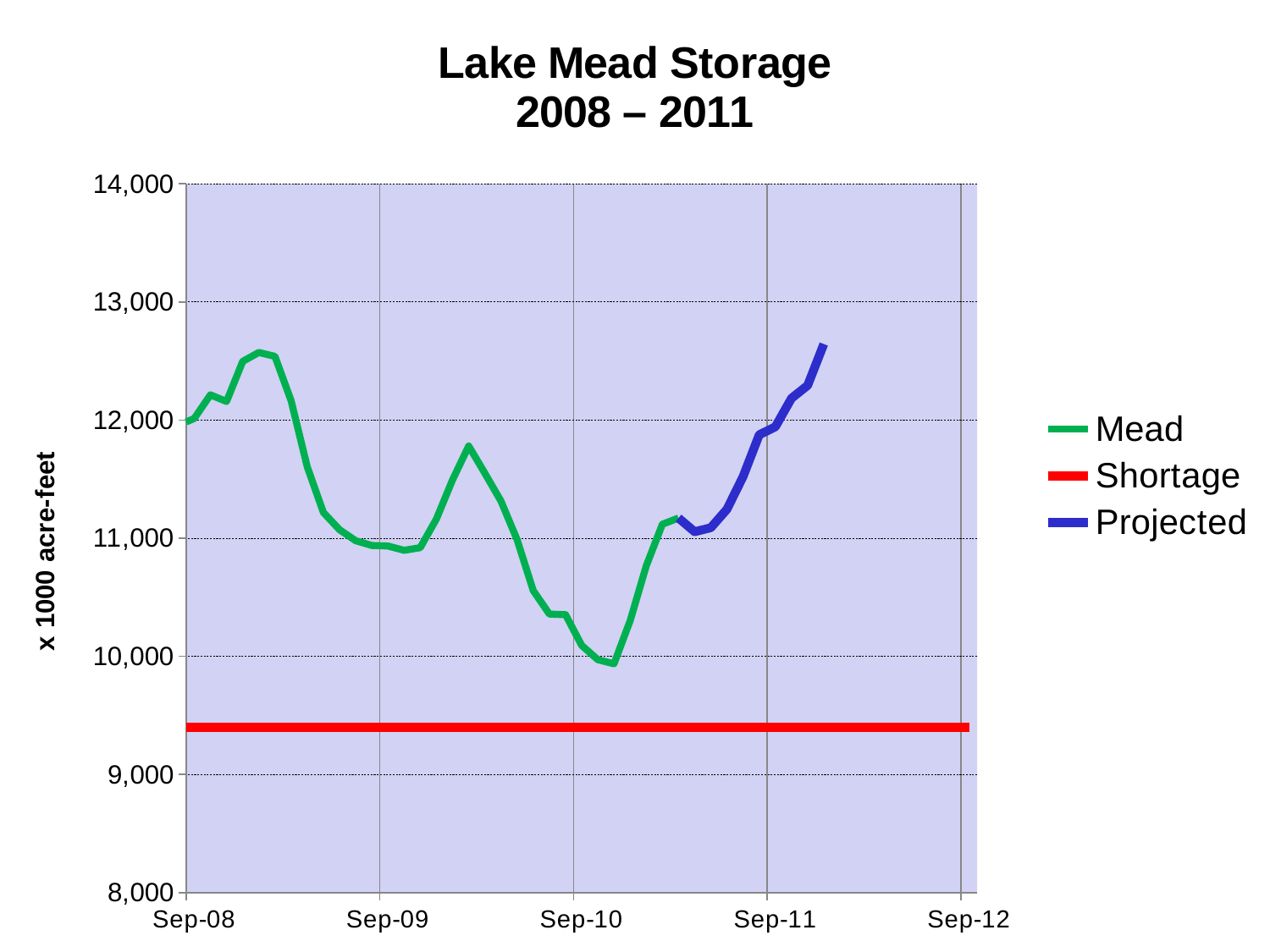
Which is larger, the Mead value at Sep-08 or the Mead value at Sep-10? Sep-08 Is the Mead value at Sep-10 greater or less than 11,000? less Is the value of the Shortage line greater or less than 9,000? greater Which is larger at Sep-10, the Mead line or the Shortage line? Mead What kind of chart is shown on the slide? Line chart Is the value of the Shortage line greater or less than 10,000? less Does the Projected line rise or fall from left to right? Rises What is the title of the chart? Lake Mead Storage 2008 – 2011 What is the label on the vertical axis? x 1000 acre-feet Does the Mead line rise or fall overall between Sep-08 and Sep-09? Falls How many series does the legend list? 3